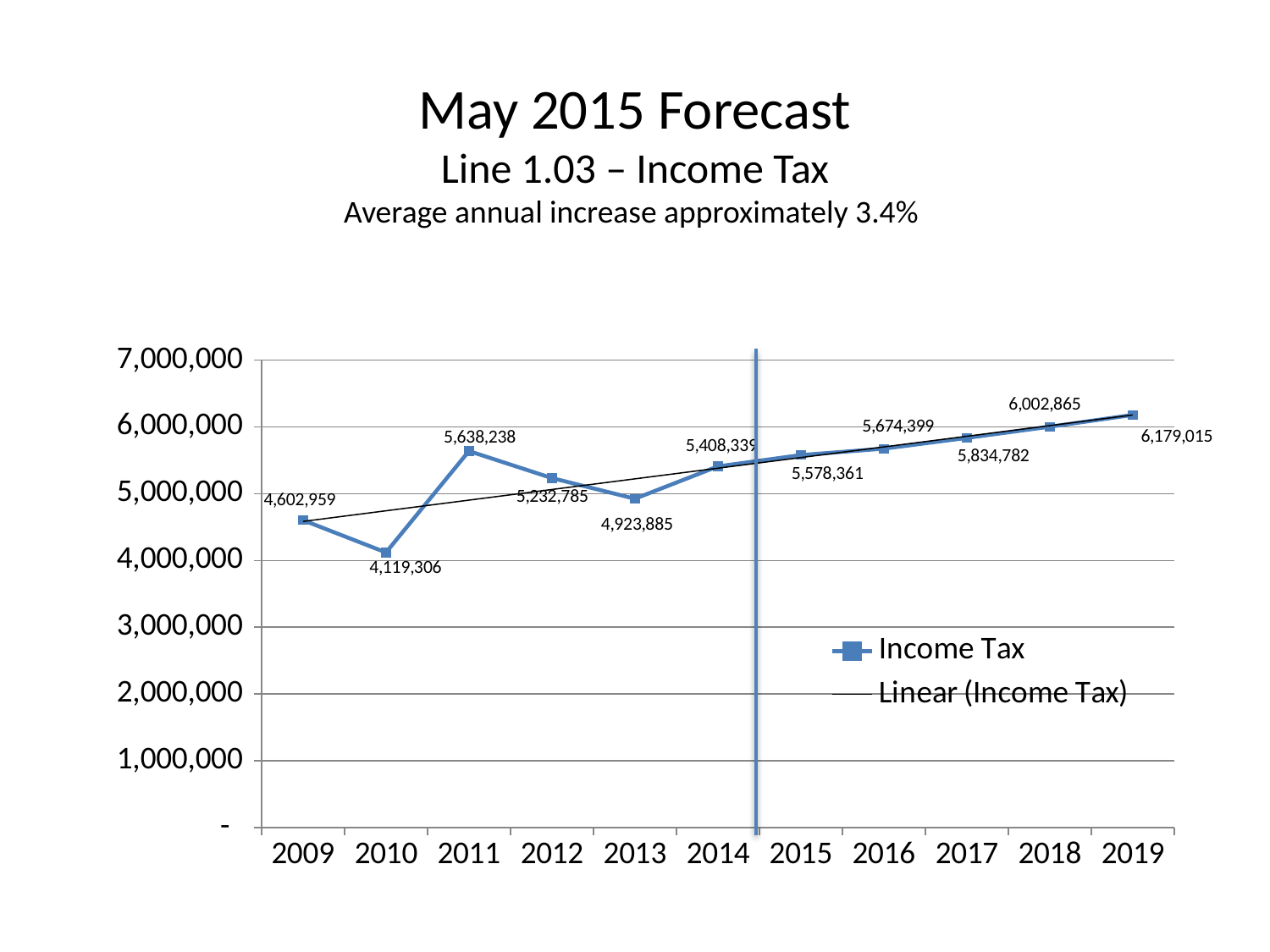
How many years are plotted on the x axis? 11 What is the Income Tax value for 2014? 5,408,339 Which year has the lowest Income Tax value? 2010 Is the Income Tax value for 2010 greater or less than 5,000,000? less Which year has a larger Income Tax value, 2011 or 2012? 2011 What kind of chart is shown on the slide? line chart What is the Income Tax value for 2011? 5,638,238 How many entries does the legend list? 2 What is the Income Tax value for 2019? 6,179,015 Which year has the highest Income Tax value? 2019 Do the Income Tax values generally rise or fall from 2013 to 2019? rise What is the difference between the Income Tax values for 2019 and 2009? 1,576,056